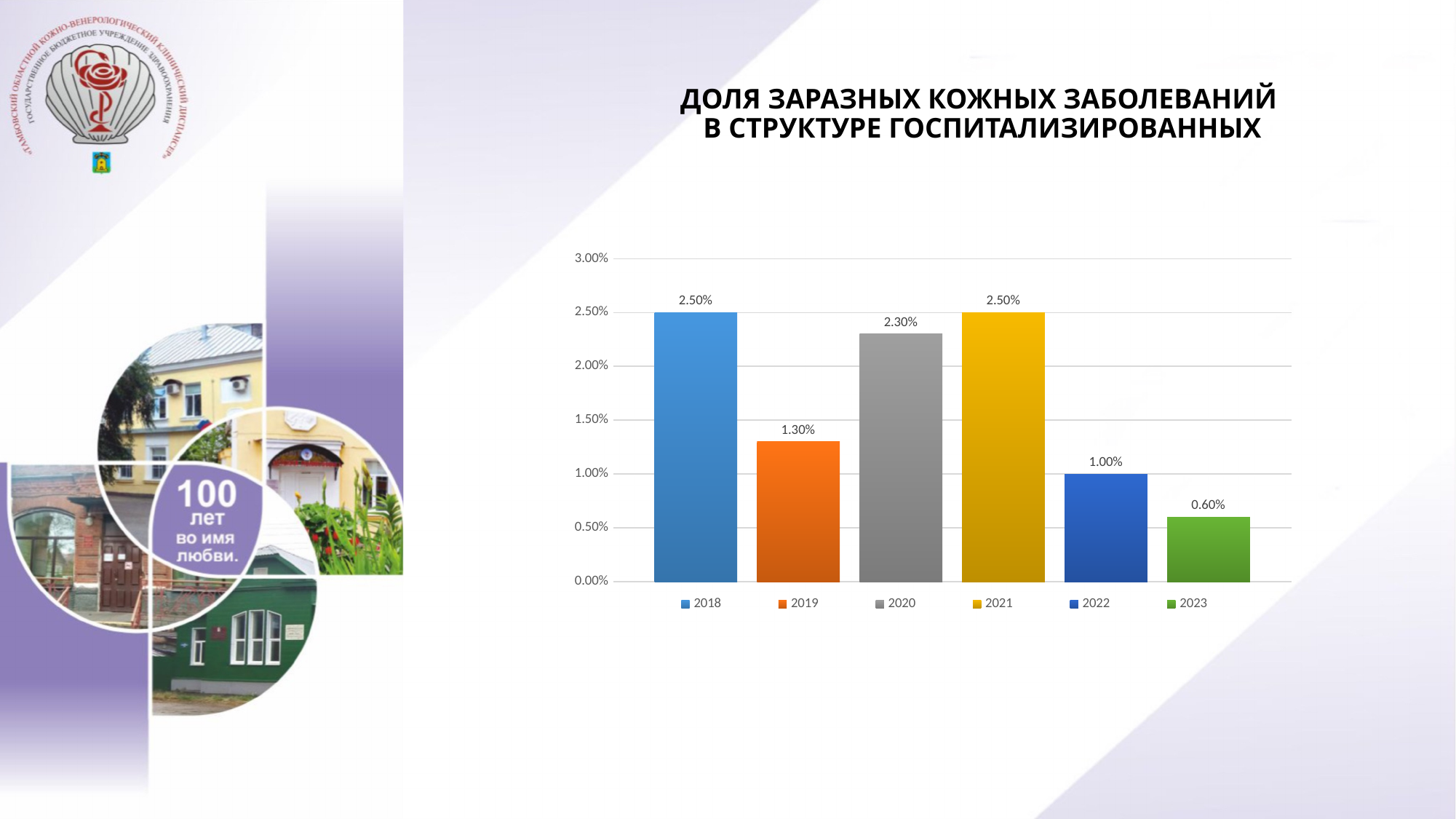
What is the difference between the values for 2021 and 2023? 1.90% What kind of chart is shown on the slide? bar chart Is the value for 2020 greater or less than 2.00%? greater What is the value for 2019? 1.30% How many years are shown in the chart? 6 What is the difference between the values for 2020 and 2019? 1.00% What is the value for 2022? 1.00% What is the value for 2020? 2.30% What is the value for 2018? 2.50% Which is larger, the value for 2019 or the value for 2022? 2019 Which year has the lowest value? 2023 What colour is the bar for 2021? yellow